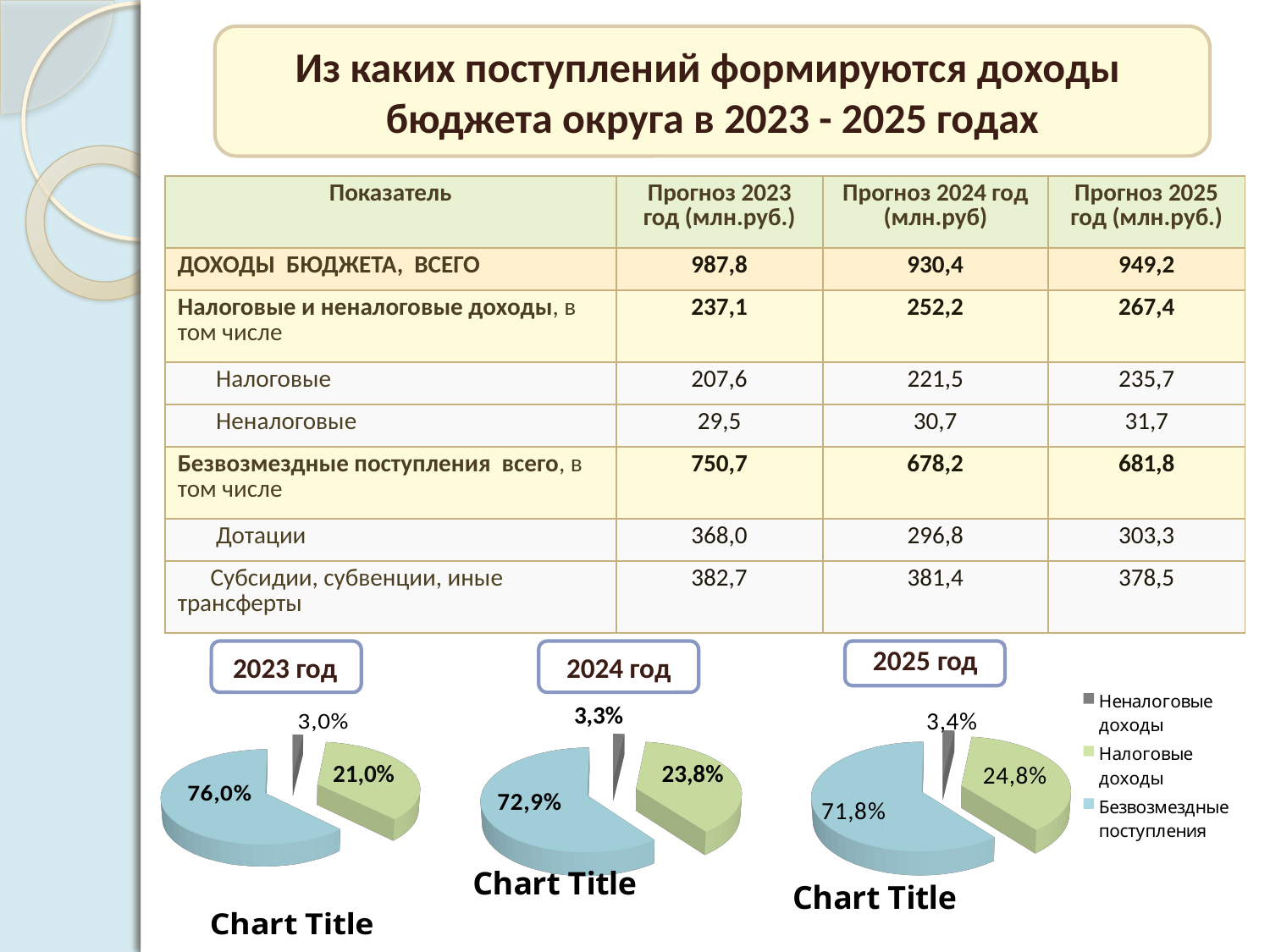
What colour represents Налоговые доходы in the pie charts? Green What type of chart is used for the 2023 год, 2024 год and 2025 год charts? Pie chart How many slices does the 2024 год pie chart have? 3 Which is larger: the share of Налоговые доходы in the 2023 год chart or in the 2025 год chart? 2025 год In the 2025 год pie chart, which category has the largest slice? Безвозмездные поступления In the 2023 год pie chart, what share is shown for Безвозмездные поступления? 76,0% How many entries does the legend next to the pie charts list? 3 Across the 2023 год, 2024 год and 2025 год pie charts, does the share of Безвозмездные поступления rise or fall from year to year? Fall In the 2024 год pie chart, what is the difference between the shares of Безвозмездные поступления and Налоговые доходы? 49,1% In the 2023 год pie chart, which category has the smallest slice? Неналоговые доходы In the 2025 год pie chart, what share is shown for Неналоговые доходы? 3,4% In the 2024 год pie chart, what share is shown for Налоговые доходы? 23,8%